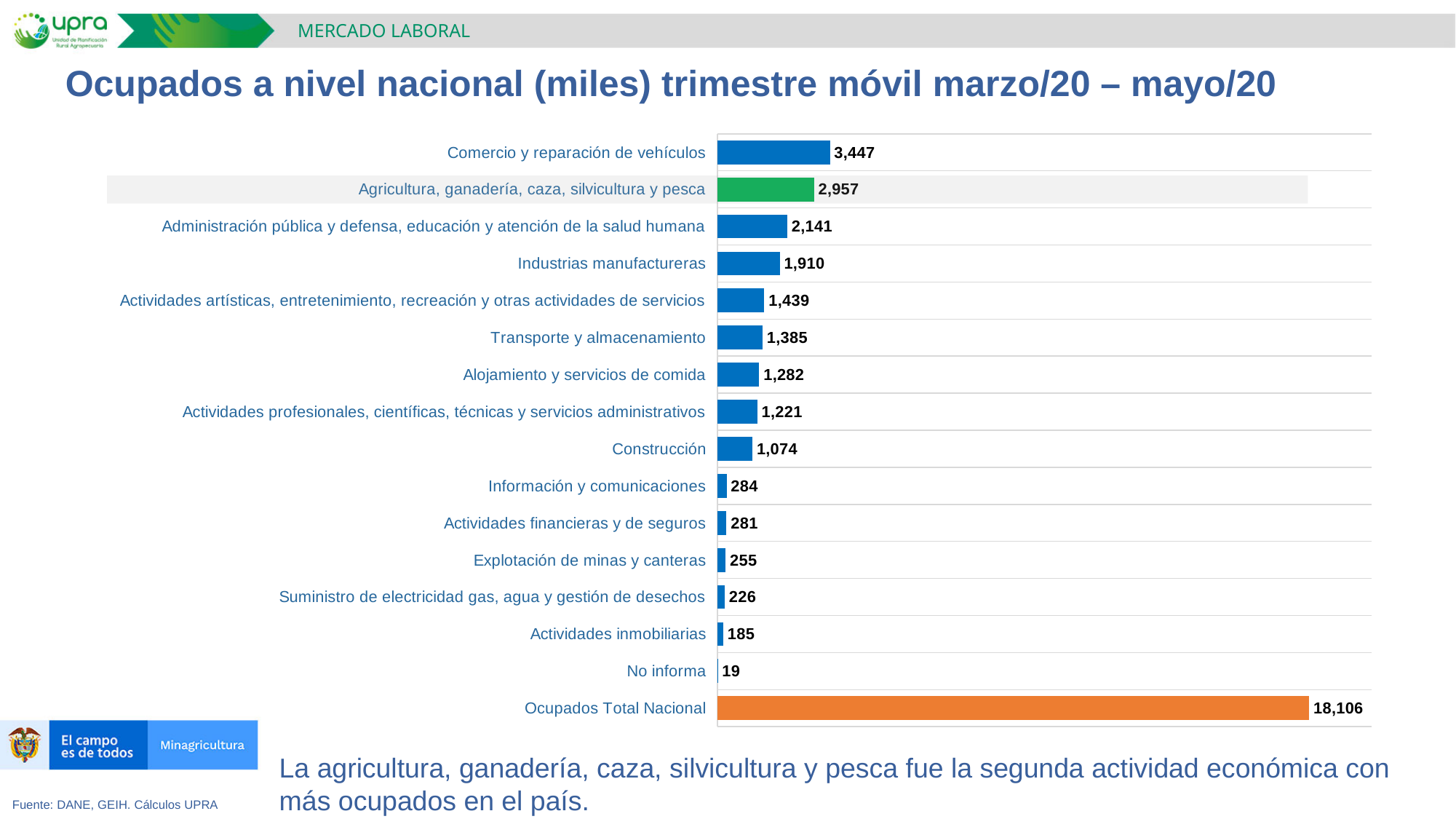
Which is larger, Industrias manufactureras or Transporte y almacenamiento? Industrias manufactureras What is the value for Agricultura, ganadería, caza, silvicultura y pesca? 2,957 What kind of chart is shown on the slide? Bar chart What is the difference between Comercio y reparación de vehículos and Agricultura, ganadería, caza, silvicultura y pesca? 490 What is the value for Ocupados Total Nacional? 18,106 What colour is the bar for Agricultura, ganadería, caza, silvicultura y pesca? Green What is the value for Comercio y reparación de vehículos? 3,447 How many bars are shown in the chart? 16 What is the value for Construcción? 1,074 Which category has the lowest value? No informa Excluding Ocupados Total Nacional, which category has the highest value? Comercio y reparación de vehículos What is the difference between Alojamiento y servicios de comida and Construcción? 208